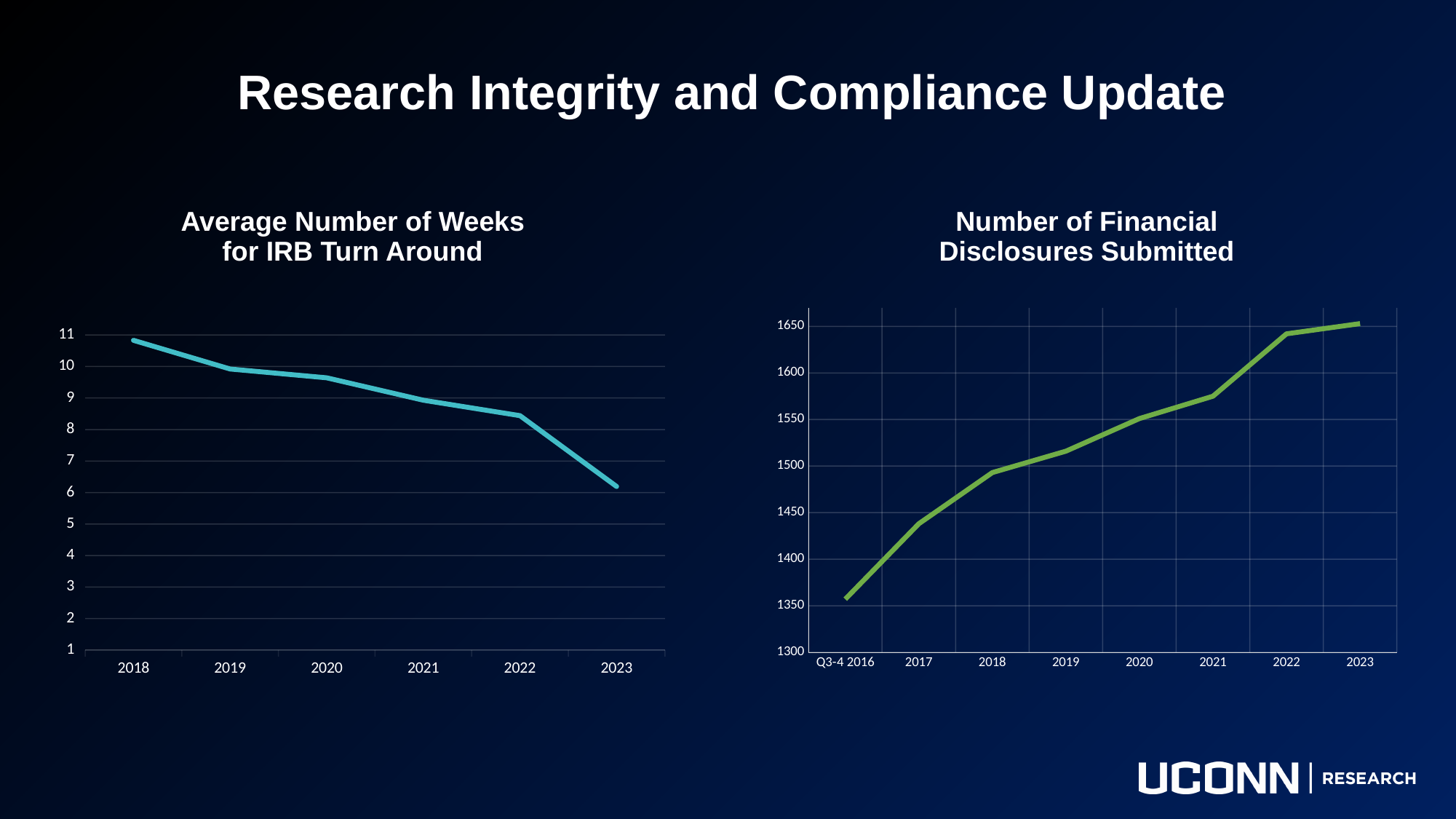
What kind of chart is the 'Average Number of Weeks for IRB Turn Around' chart? line chart In the 'Number of Financial Disclosures Submitted' chart, is the value for 2022 greater or less than 1600? greater In the 'Number of Financial Disclosures Submitted' chart, which is larger, the value for 2018 or the value for 2021? 2021 In the 'Average Number of Weeks for IRB Turn Around' chart, which year has the highest value? 2018 In the 'Number of Financial Disclosures Submitted' chart, which period has the lowest value? Q3-4 2016 In the 'Average Number of Weeks for IRB Turn Around' chart, is the value for 2023 greater or less than 7? less In the 'Average Number of Weeks for IRB Turn Around' chart, do the values rise or fall from 2018 to 2023? fall In the 'Average Number of Weeks for IRB Turn Around' chart, which year has the lowest value? 2023 How many points are plotted in the 'Number of Financial Disclosures Submitted' chart? 8 In the 'Number of Financial Disclosures Submitted' chart, do the values rise or fall from Q3-4 2016 to 2023? rise What kind of chart is the 'Number of Financial Disclosures Submitted' chart? line chart How many years are shown on the x axis of the 'Average Number of Weeks for IRB Turn Around' chart? 6